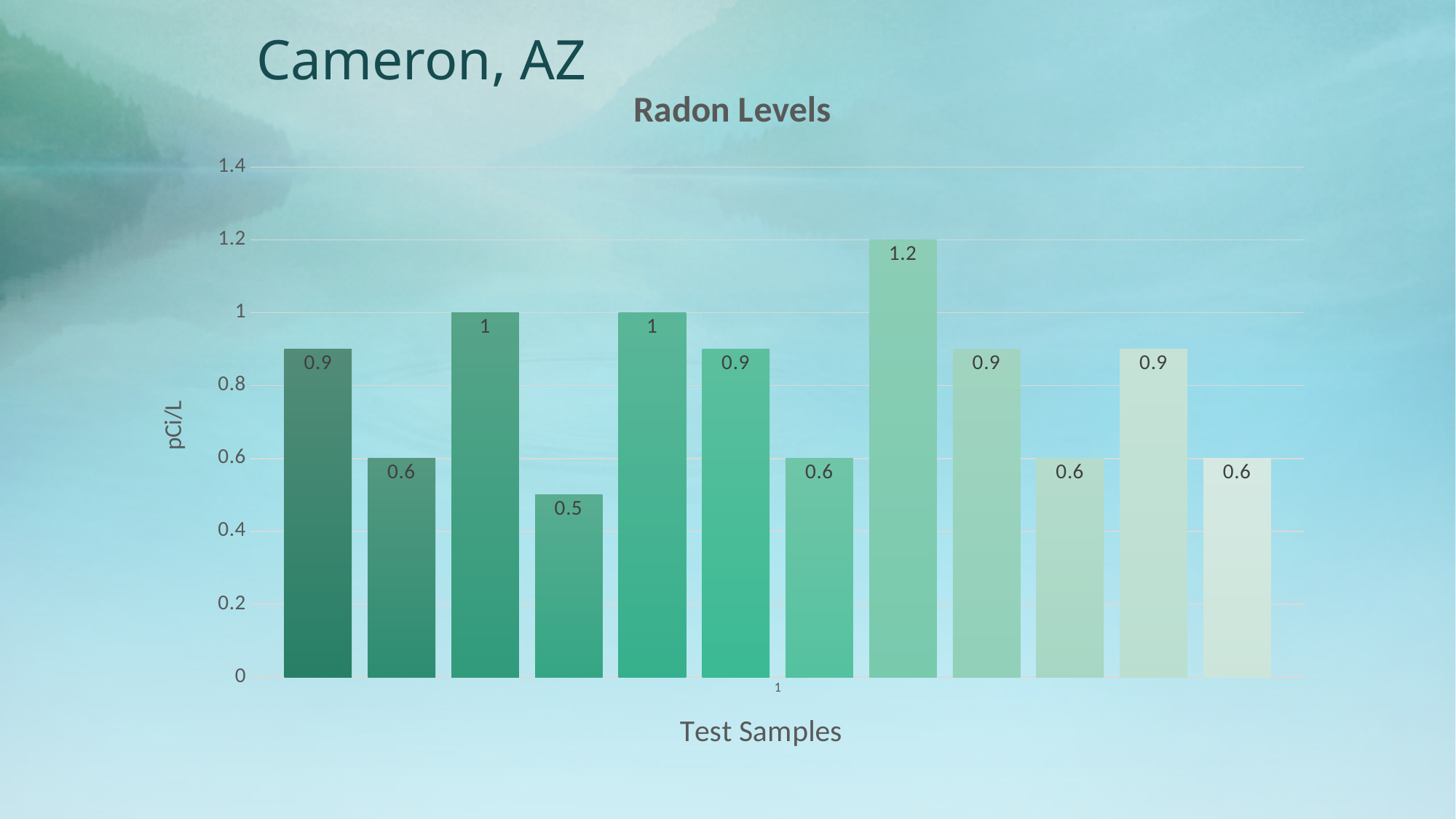
What is the value of the fourth bar from the left in the chart? 0.5 What is the value of the first (leftmost) bar in the chart? 0.9 What kind of chart is shown on the slide? bar chart What is the value of the eighth bar from the left in the chart? 1.2 Which is larger, the value of the third bar or the value of the second bar? the third bar What is the title of the chart? Radon Levels How many bars are plotted in the chart? 12 What is the difference between the highest bar (1.2) and the lowest bar (0.5) in the chart? 0.7 Is the value of the last (rightmost) bar greater or less than 0.8? less What is the highest value shown in the chart? 1.2 What is the label on the vertical axis of the chart? pCi/L What is the lowest value shown in the chart? 0.5